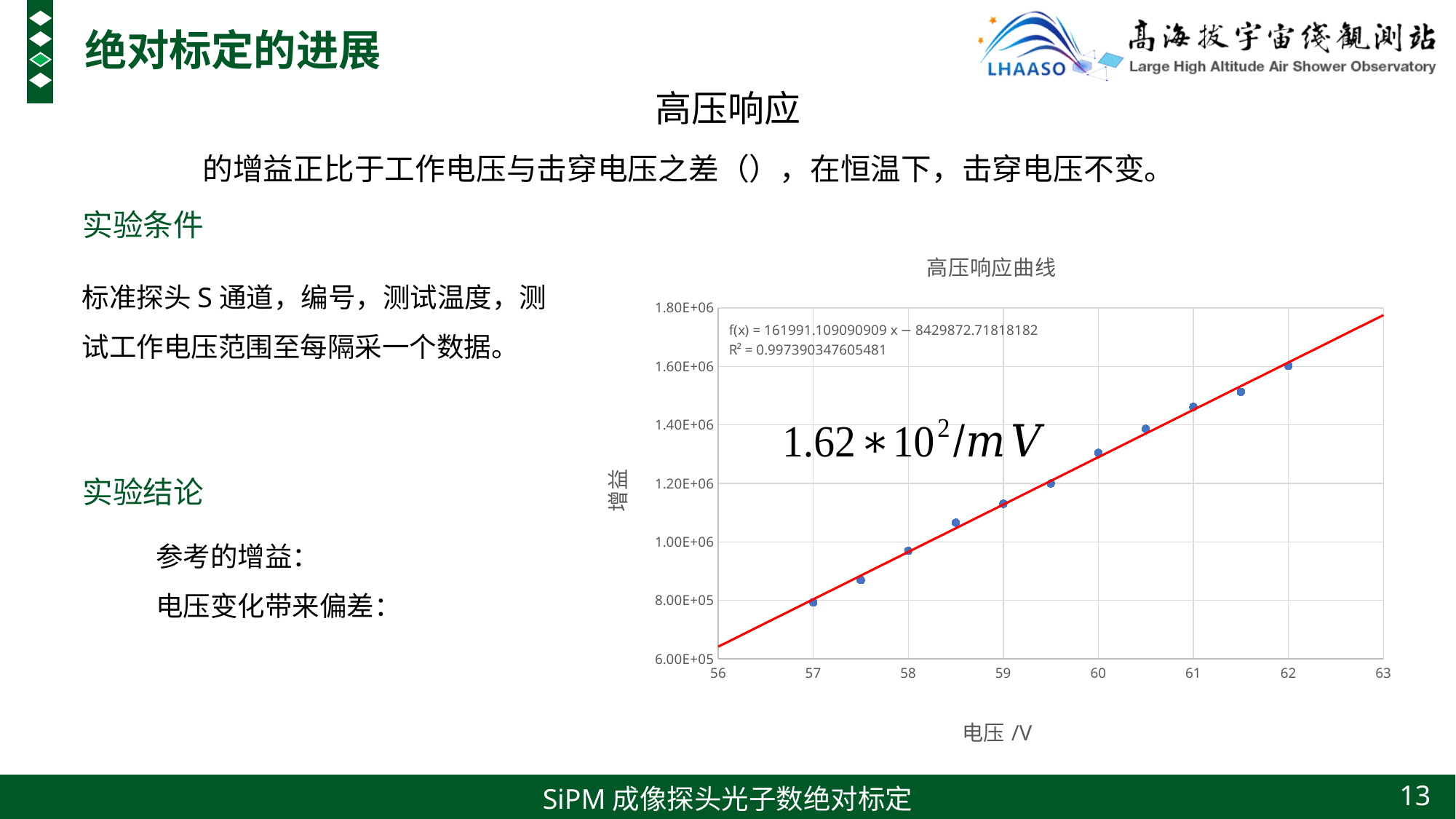
Is the gain value at 58 V greater or less than 1.20E+06? less Is the gain value at 60 V greater or less than 1.20E+06? greater Which has the larger gain, the point at 62 V or the point at 57 V? 62 V How many data points are plotted in the 高压响应曲线 chart? 11 What kind of chart is shown on the slide? Scatter chart At which voltage is the plotted gain highest? 62 Is the gain value at 59 V greater or less than 1.00E+06? greater At which voltage is the plotted gain lowest? 57 What is the title of the chart? 高压响应曲线 What R² value is printed on the chart for the fitted line? 0.997390347605481 Do the gain values rise or fall as the voltage increases along the x axis? Rise